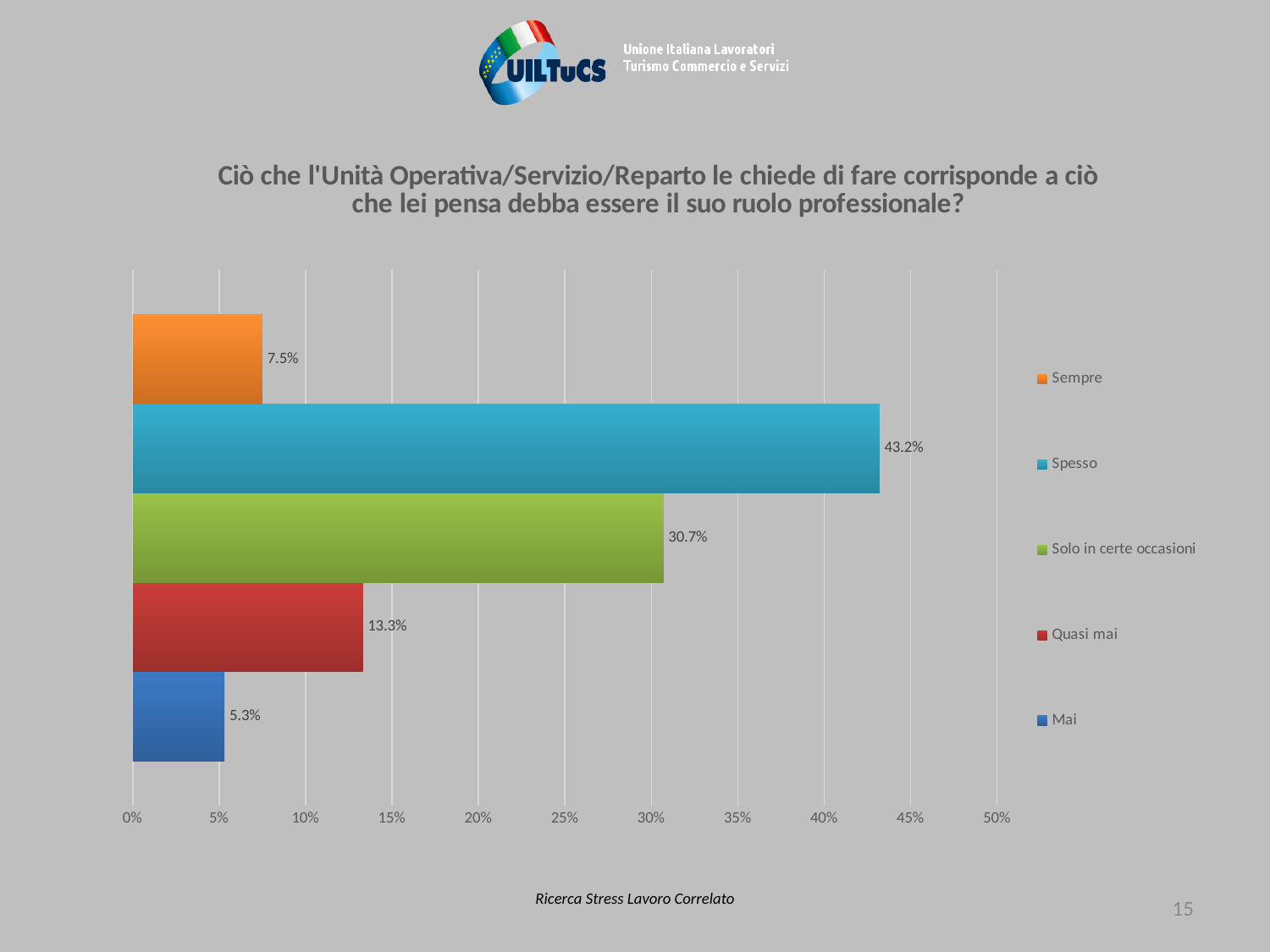
What is the value for Sempre? 7.5% Which category has the highest value? Spesso What colour is the bar for Solo in certe occasioni? Green What is the value for Quasi mai? 13.3% How many categories does the chart show? 5 What is the value for Solo in certe occasioni? 30.7% What is the value for Spesso? 43.2% What is the difference between the values for Spesso and Solo in certe occasioni? 12.5% Which category has the lowest value? Mai Which is larger, the value for Quasi mai or the value for Sempre? Quasi mai What is the value for Mai? 5.3% What kind of chart is shown on the slide? Bar chart